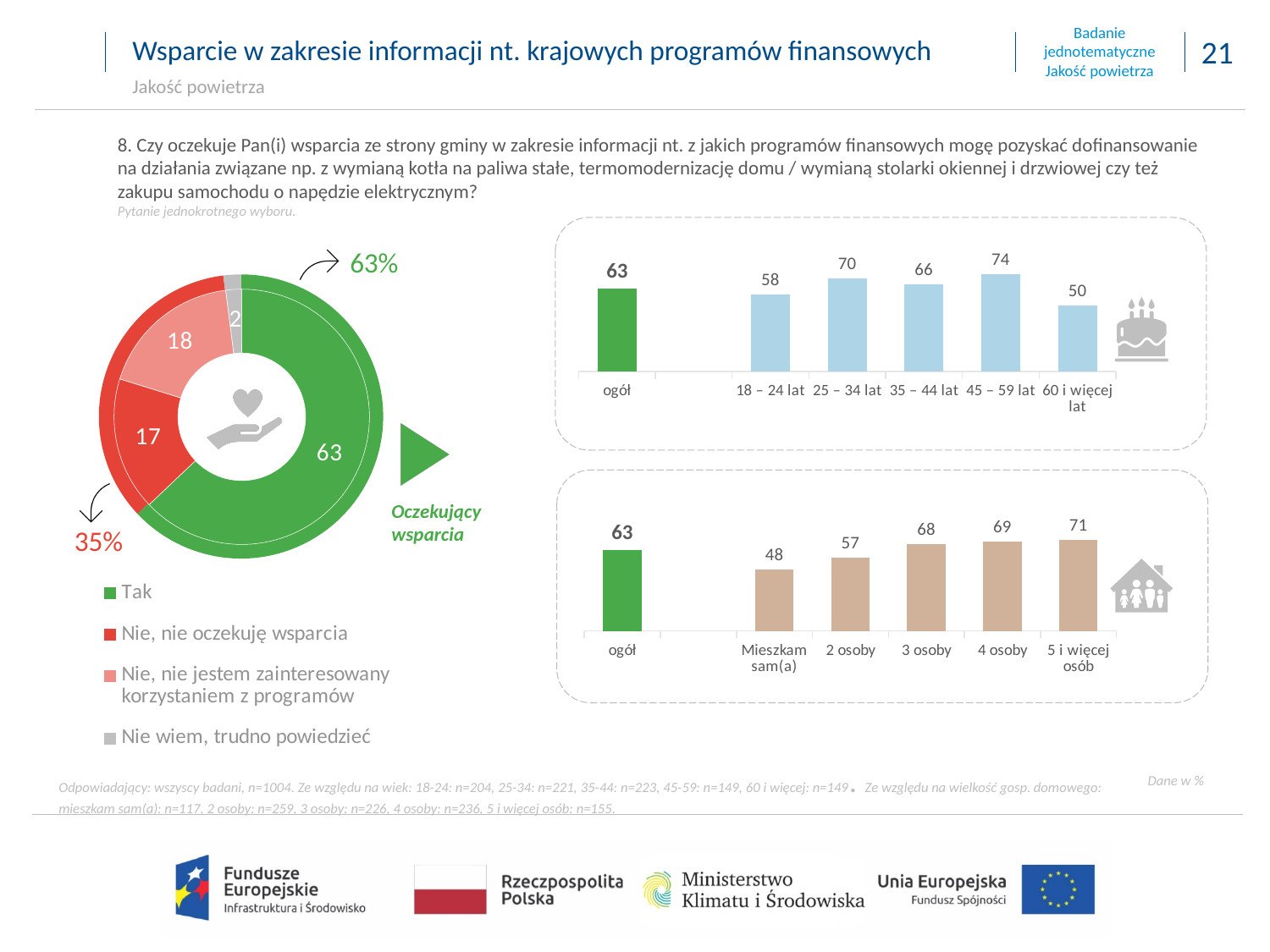
In the top-right bar chart by age, which age group has the lowest value? 60 i więcej lat In the bottom-right bar chart by household size, which category has the highest value? 5 i więcej osób In the donut chart on the left, what is the value for "Nie, nie jestem zainteresowany korzystaniem z programów"? 18 In the top-right bar chart by age, how many bars are plotted? 6 In the donut chart on the left, what is the value for "Tak"? 63 In the bottom-right bar chart by household size, what is the value for "Mieszkam sam(a)"? 48 How many entries does the legend of the donut chart on the left list? 4 In the top-right bar chart by age, what is the difference between the values for "25 – 34 lat" and "18 – 24 lat"? 12 What type of chart is the bottom-right chart by household size? bar chart In the bottom-right bar chart by household size, do the values rise or fall from "Mieszkam sam(a)" to "5 i więcej osób"? rise In the donut chart on the left, which category has the smallest value? Nie wiem, trudno powiedzieć In the top-right bar chart by age, what is the value for "45 – 59 lat"? 74